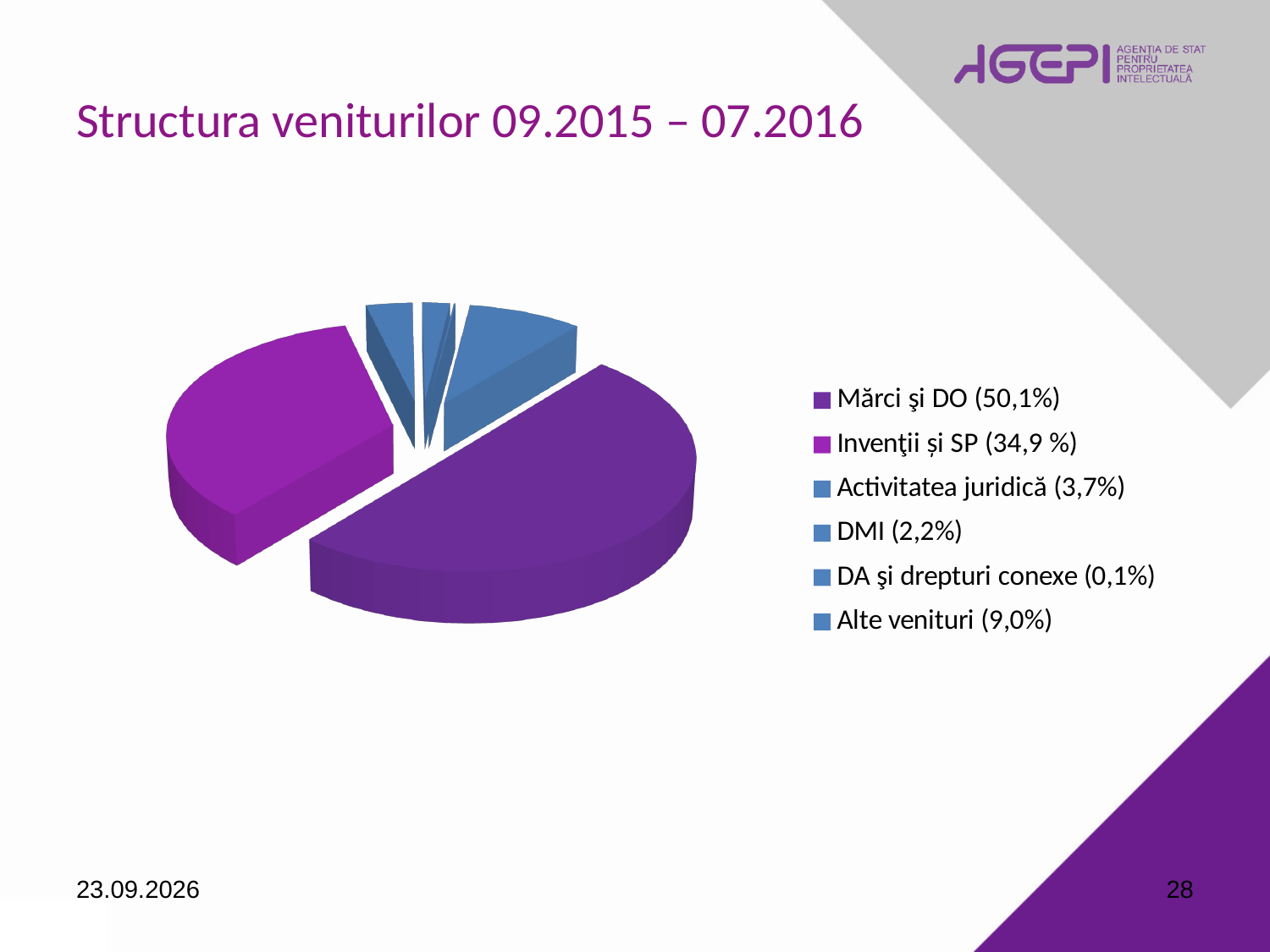
How many categories does the pie chart have? 6 What is the title of the chart on the slide? Structura veniturilor 09.2015 – 07.2016 What is the value shown for Activitatea juridică? 3,7% Which category has the largest share of the pie? Mărci şi DO What is the value shown for Alte venituri? 9,0% What share of the pie does Mărci şi DO represent? 50,1% Which category has the smallest share of the pie? DA şi drepturi conexe What share of the pie does Invenţii și SP represent? 34,9 % What kind of chart is shown on the slide? pie chart What is the difference in percentage points between Mărci şi DO and Invenţii și SP? 15,2 Which is larger, the share for Alte venituri or the share for Activitatea juridică? Alte venituri What is the value shown for DMI? 2,2%